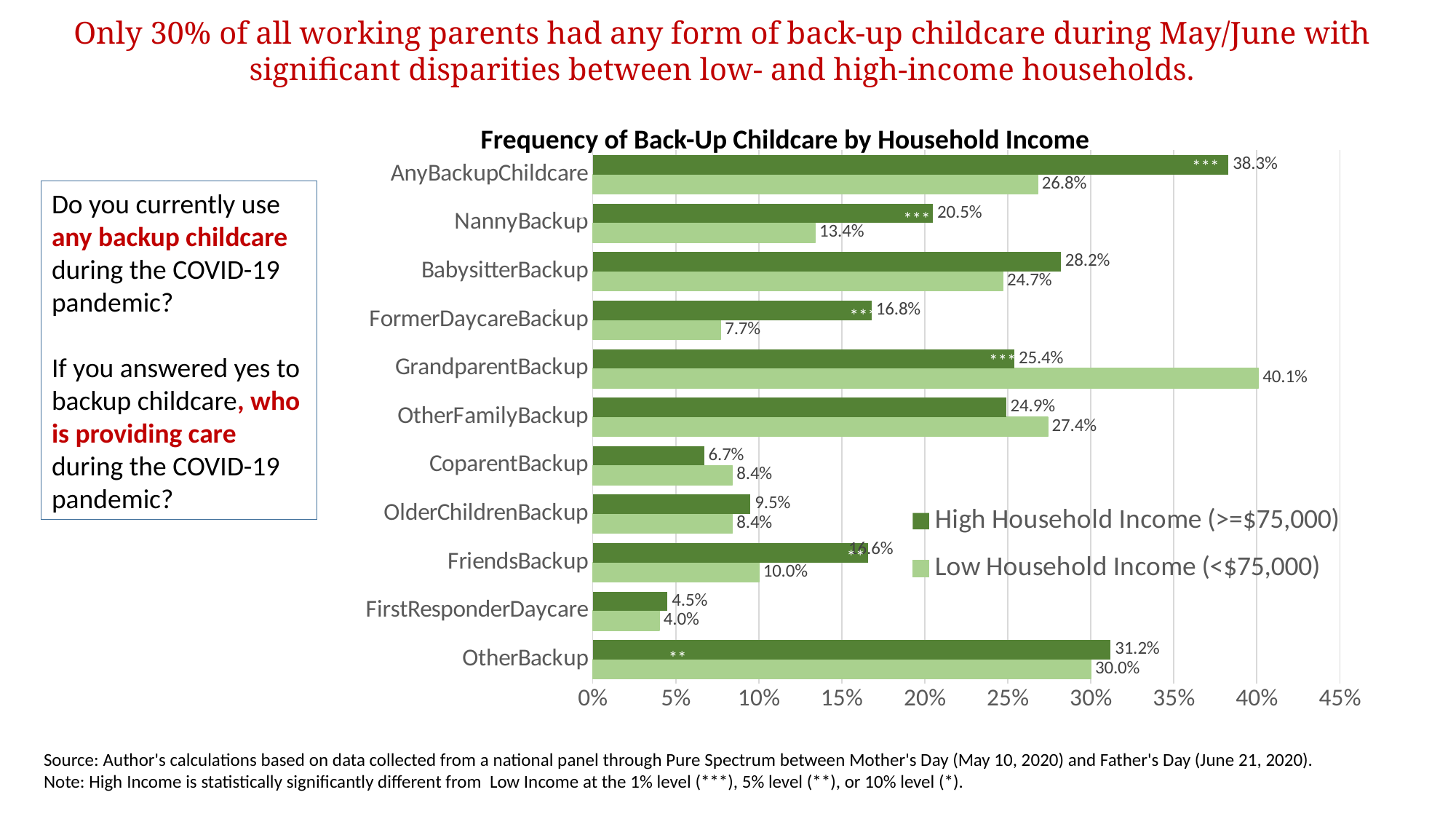
Which category has the highest value for Low Household Income (<$75,000)? GrandparentBackup Is the High Household Income value for FriendsBackup greater or less than 20%? less What is the title of the chart? Frequency of Back-Up Childcare by Household Income What is the value for Low Household Income (<$75,000) for NannyBackup? 13.4% For FormerDaycareBackup, what is the difference between the High Household Income and Low Household Income values? 9.1 percentage points What kind of chart is shown on the slide? bar chart For OtherFamilyBackup, which series has the larger value, High Household Income or Low Household Income? Low Household Income (<$75,000) How many series does the legend list? 2 What is the value for High Household Income (>=$75,000) for AnyBackupChildcare? 38.3% What is the value for Low Household Income (<$75,000) for GrandparentBackup? 40.1% How many categories are shown on the chart? 11 Which category has the lowest value for High Household Income (>=$75,000)? FirstResponderDaycare